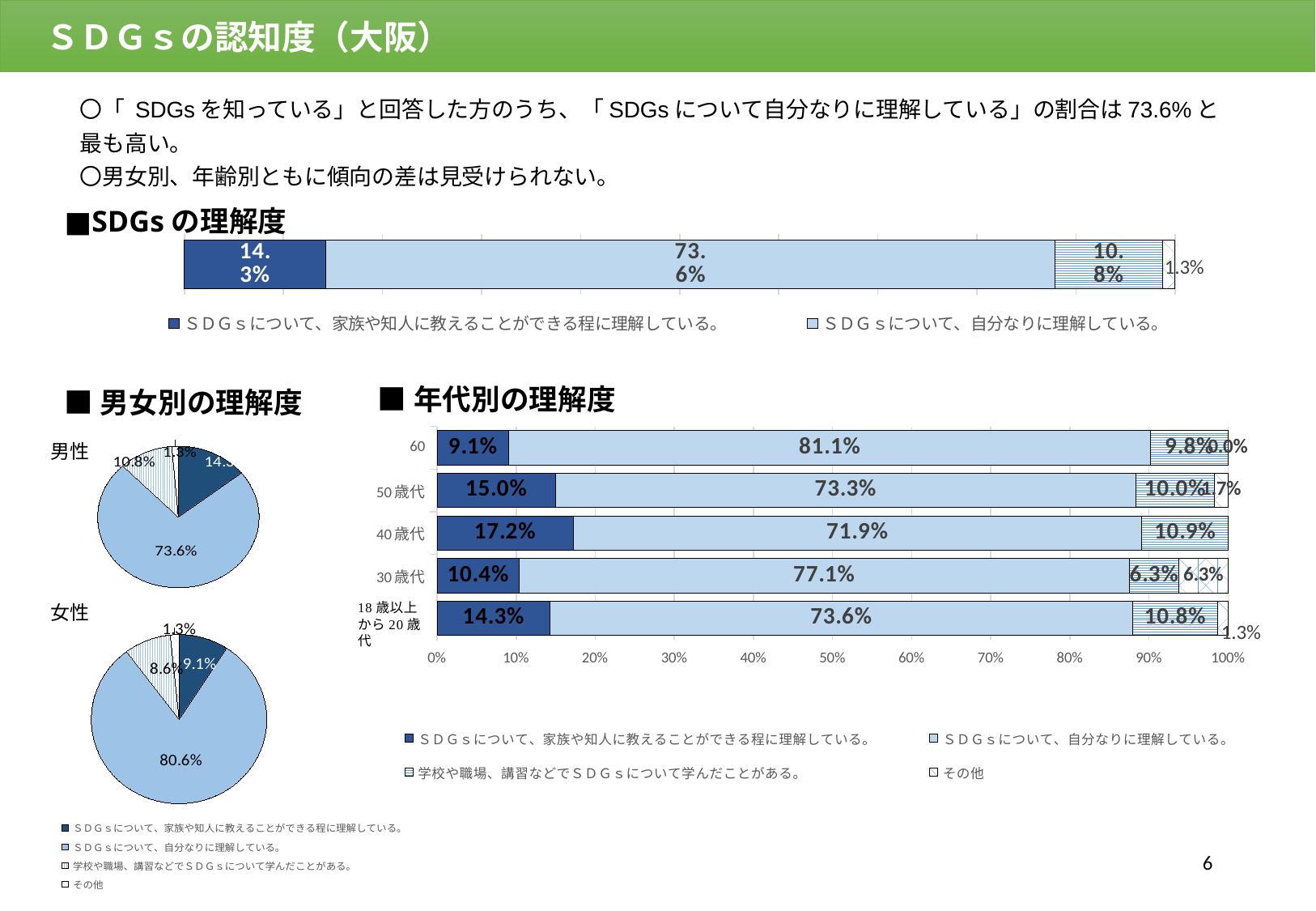
In the '年代別の理解度' bar chart, what is the value for 40歳代 in the 'SDGsについて、家族や知人に教えることができる程に理解している' series? 17.2% In the '年代別の理解度' bar chart, which is larger for 'SDGsについて、自分なりに理解している': 30歳代 or 50歳代? 30歳代 In the 女性 pie chart, what is the value of the largest slice? 80.6% How many series does the legend of the '年代別の理解度' chart list? 4 In the '年代別の理解度' bar chart, which age group has the highest value for 'SDGsについて、自分なりに理解している'? 60 What kind of charts are used in the '男女別の理解度' section? Pie charts In the 女性 pie chart, what percentage is shown for the slice labelled with the vertical-stripe pattern (学校や職場、講習などでSDGsについて学んだことがある)? 8.6% In the 男性 pie chart, what is the value of the largest slice? 73.6% How many age groups are shown in the '年代別の理解度' bar chart? 5 In the top 'SDGsの理解度' bar chart, what percentage is shown for 'SDGsについて、自分なりに理解している'? 73.6% In the '年代別の理解度' bar chart, what is the difference between 50歳代 (73.3%) and 40歳代 (71.9%) for 'SDGsについて、自分なりに理解している'? 1.4 percentage points